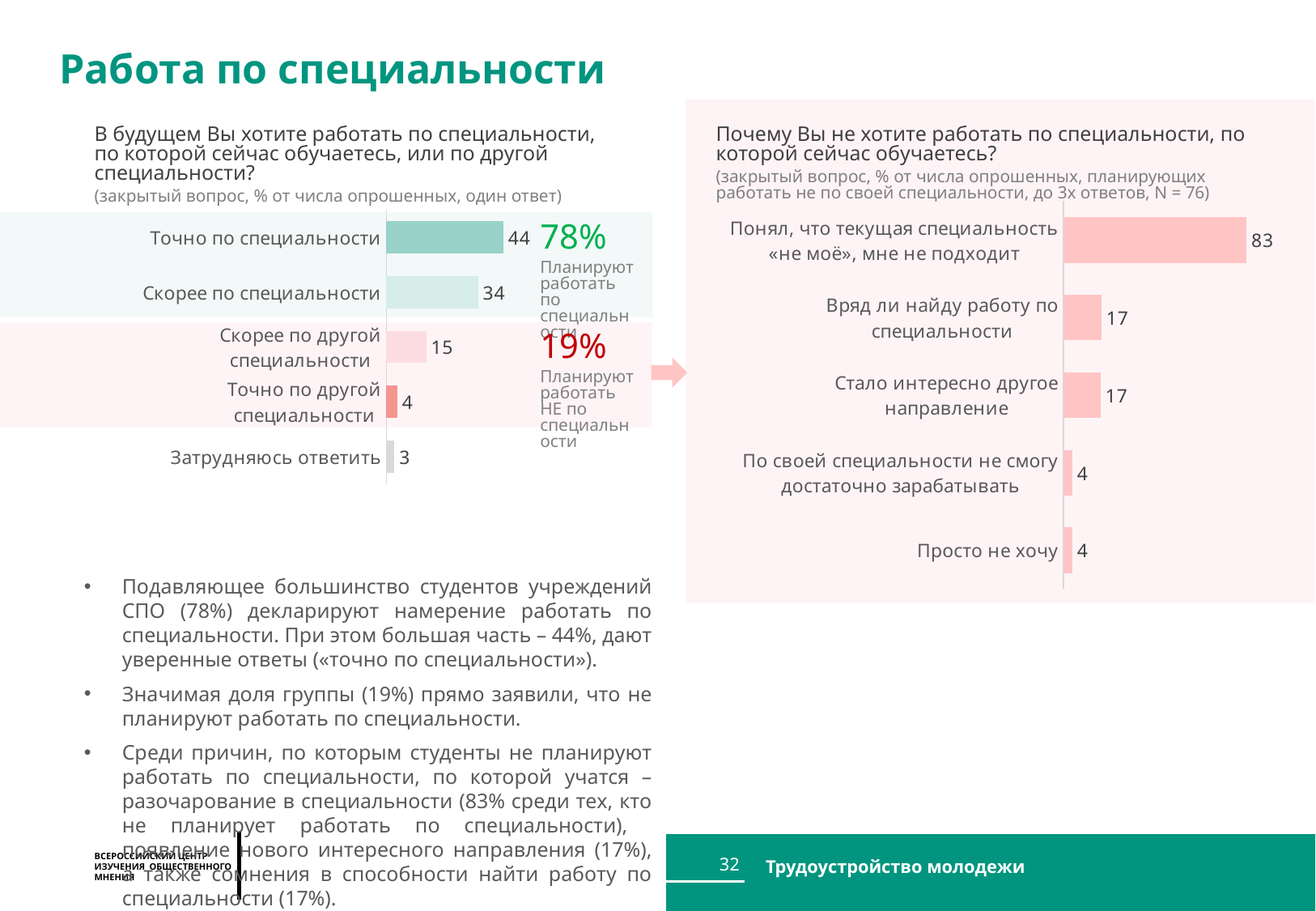
On the right chart, what is the value for «Вряд ли найду работу по специальности»? 17 On the right chart, which category has the highest value? Понял, что текущая специальность «не моё», мне не подходит On the left chart, what is the value for «Скорее по другой специальности»? 15 On the left chart, what share is labelled as planning to work in their specialty («Планируют работать по специальности»)? 78% On the right chart, how many categories are shown? 5 On the left chart, what is the difference between «Точно по специальности» and «Скорее по специальности»? 10 On the left chart, what is the value for «Точно по специальности»? 44 What type of chart is the right chart? Bar chart On the left chart, how many categories are shown? 5 On the right chart, what is the value for «Понял, что текущая специальность «не моё», мне не подходит»? 83 On the right chart, what is the difference between «Понял, что текущая специальность «не моё», мне не подходит» and «Стало интересно другое направление»? 66 On the left chart, which category has the lowest value? Затрудняюсь ответить